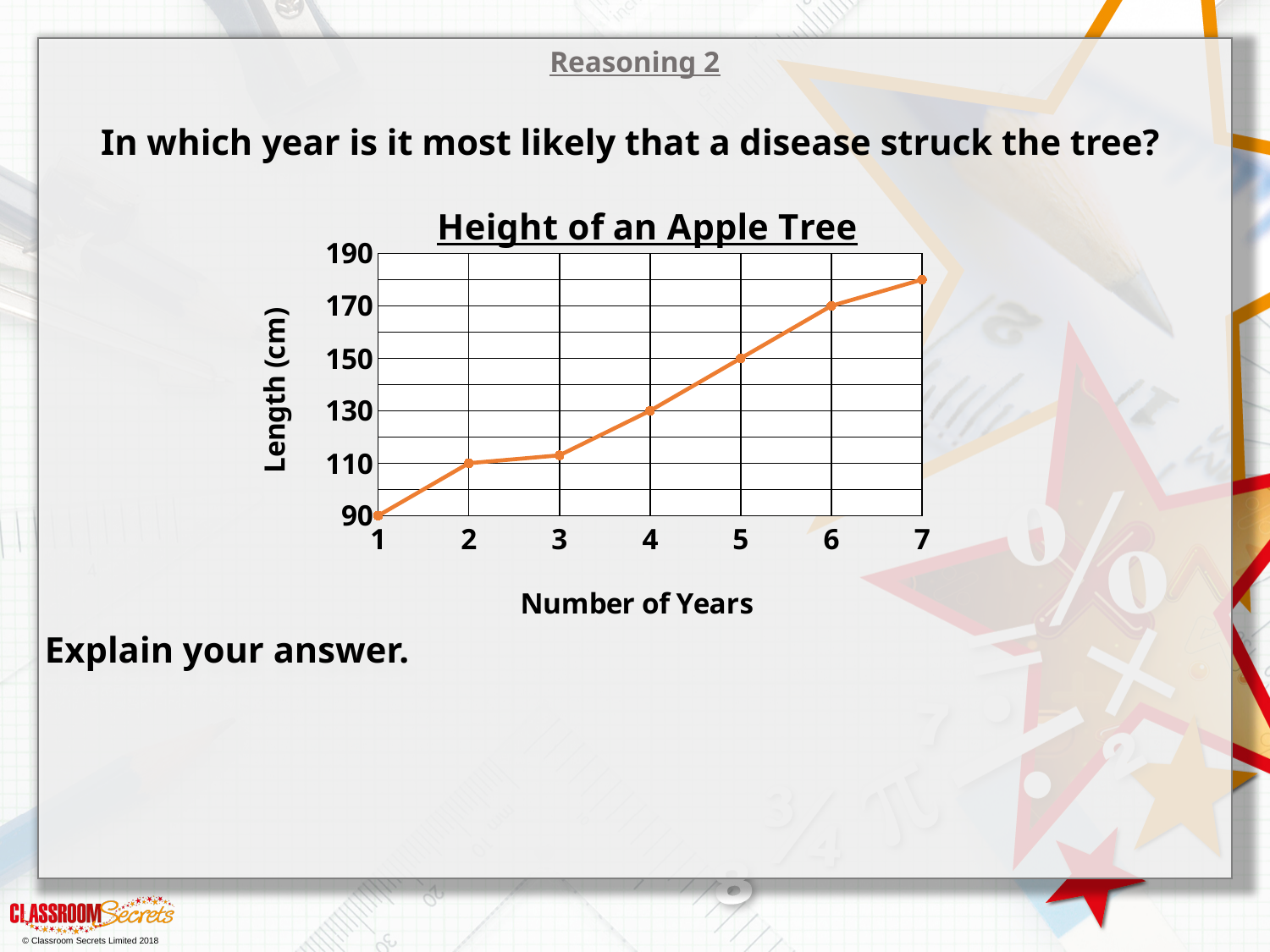
What is the height of the apple tree at year 6? 170 What is the title of the chart? Height of an Apple Tree Is the height at year 7 greater or less than 170? greater What is the height of the apple tree at year 1? 90 What is the label on the vertical axis of the chart? Length (cm) Does the height of the apple tree rise or fall as the number of years increases? rise What is the height of the apple tree at year 2? 110 What is the height of the apple tree at year 4? 130 How many data points are plotted on the chart? 7 In which year is the height of the apple tree lowest? 1 What type of chart is shown on the slide? line chart What is the difference in height between year 6 and year 2? 60